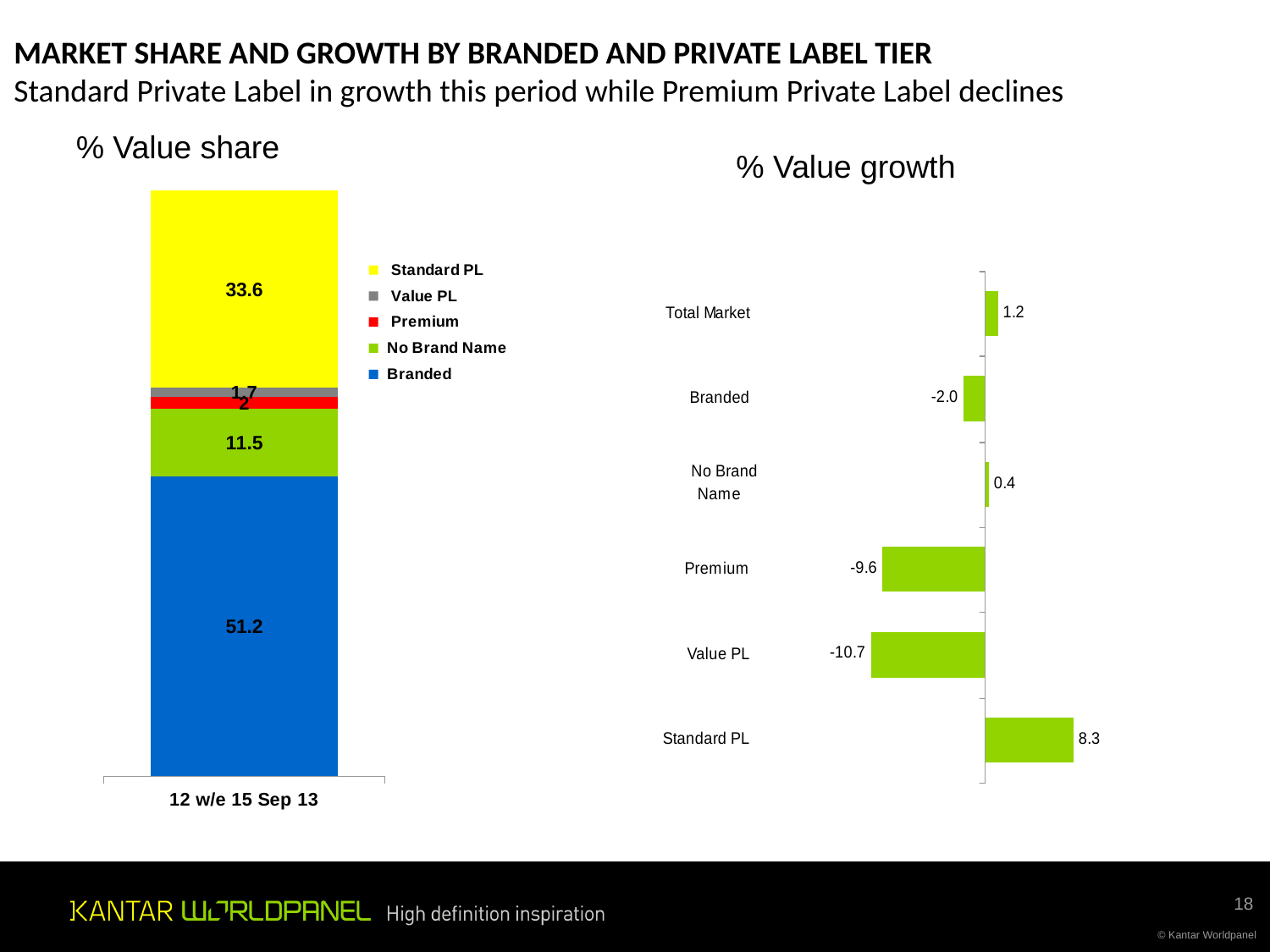
In the % Value share chart, what is the value for Standard PL? 33.6 In the % Value growth chart, which category has the highest value? Standard PL In the % Value growth chart, what is the difference between the values for Standard PL and Premium? 17.9 In the % Value share chart, what is the value for Branded? 51.2 How many categories are shown in the % Value growth chart? 6 In the % Value growth chart, what is the value for Total Market? 1.2 How many series does the legend of the % Value share chart list? 5 In the % Value growth chart, which is larger, the value for Branded or the value for No Brand Name? No Brand Name In the % Value growth chart, what is the value for Value PL? -10.7 In the % Value growth chart, what is the value for Standard PL? 8.3 In the % Value growth chart, which category has the lowest value? Value PL In the % Value share chart, what is the difference between the values for Branded and No Brand Name? 39.7